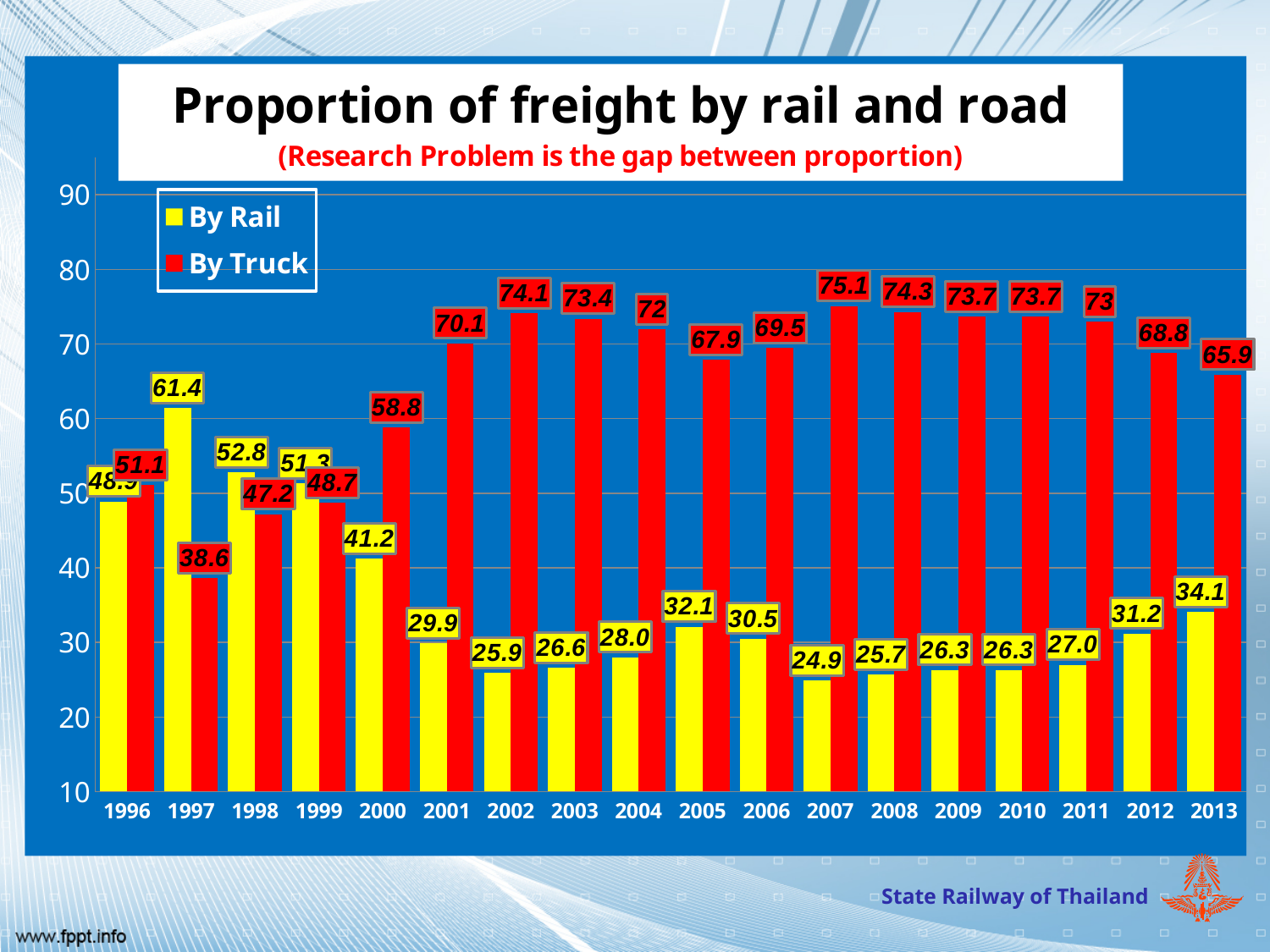
What is the By Truck value for 2000? 58.8 In which year is the By Rail value lowest? 2007 What is the difference between the By Truck and By Rail values in 2013? 31.8 Which is larger in 1997, the By Rail value or the By Truck value? By Rail What kind of chart is shown on the slide? Bar chart What is the By Rail value for 1997? 61.4 How many years are shown on the x axis? 18 What is the By Truck value for 2007? 75.1 How many series does the legend list? 2 In which year is the By Truck value highest? 2007 Does the By Truck value rise or fall from 1997 to 2002? Rise What is the By Rail value for 2013? 34.1